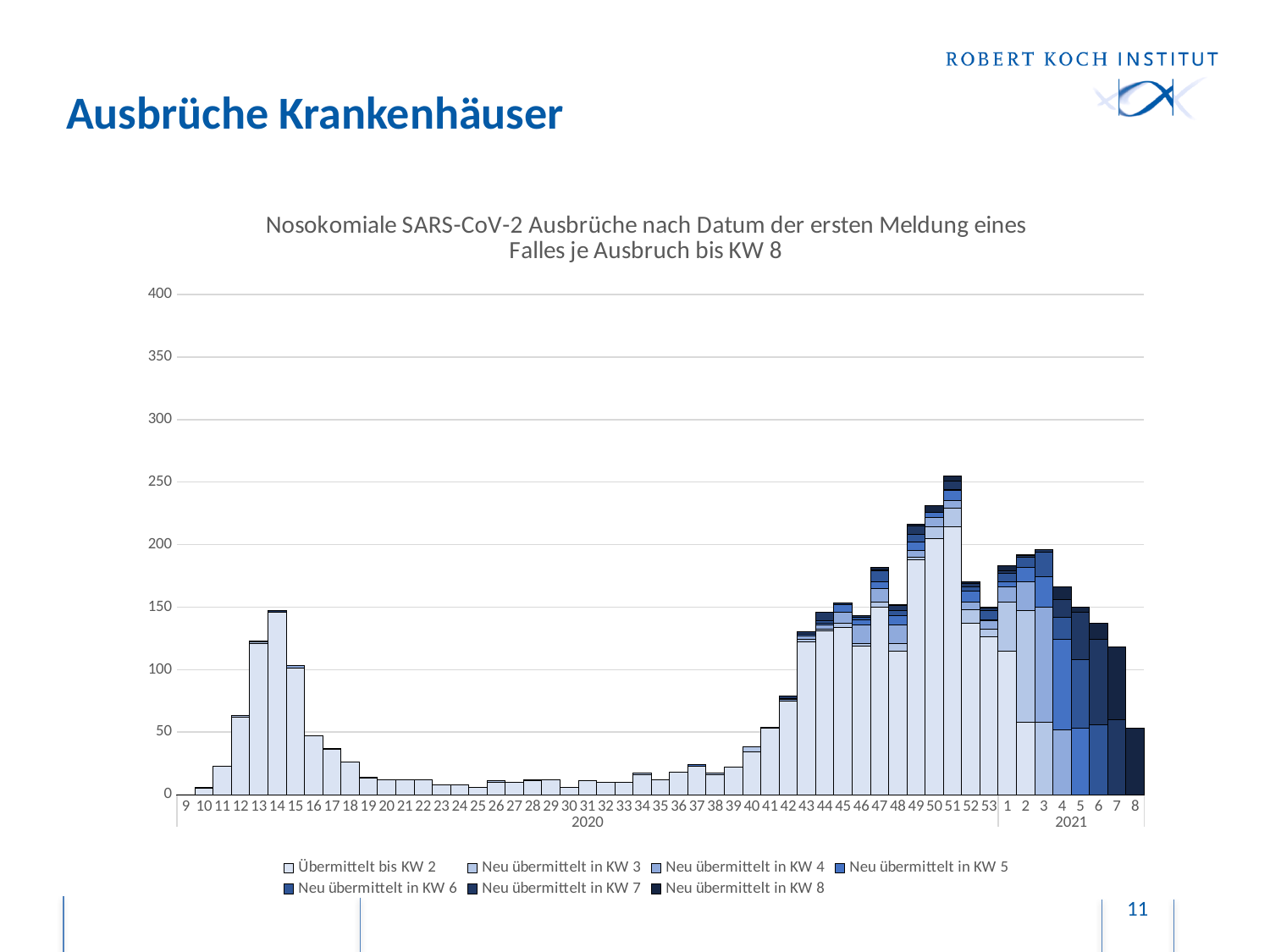
Which bar is taller, KW 14 2020 or KW 51 2020? KW 51 2020 Is the total for KW 7 2021 greater or less than 100? greater What is the first legend entry of the chart? Übermittelt bis KW 2 Is the total for KW 40 2020 greater or less than 50? less How many weekly bars are plotted in the chart? 53 Do the bar totals rise or fall from KW 9 to KW 14 of 2020? rise How many series does the legend list? 7 What kind of chart is shown on the slide? stacked bar chart Which week has the highest total bar? KW 51 2020 Which bar is taller, KW 47 2020 or KW 48 2020? KW 47 2020 Is the total for KW 51 2020 greater or less than 200? greater